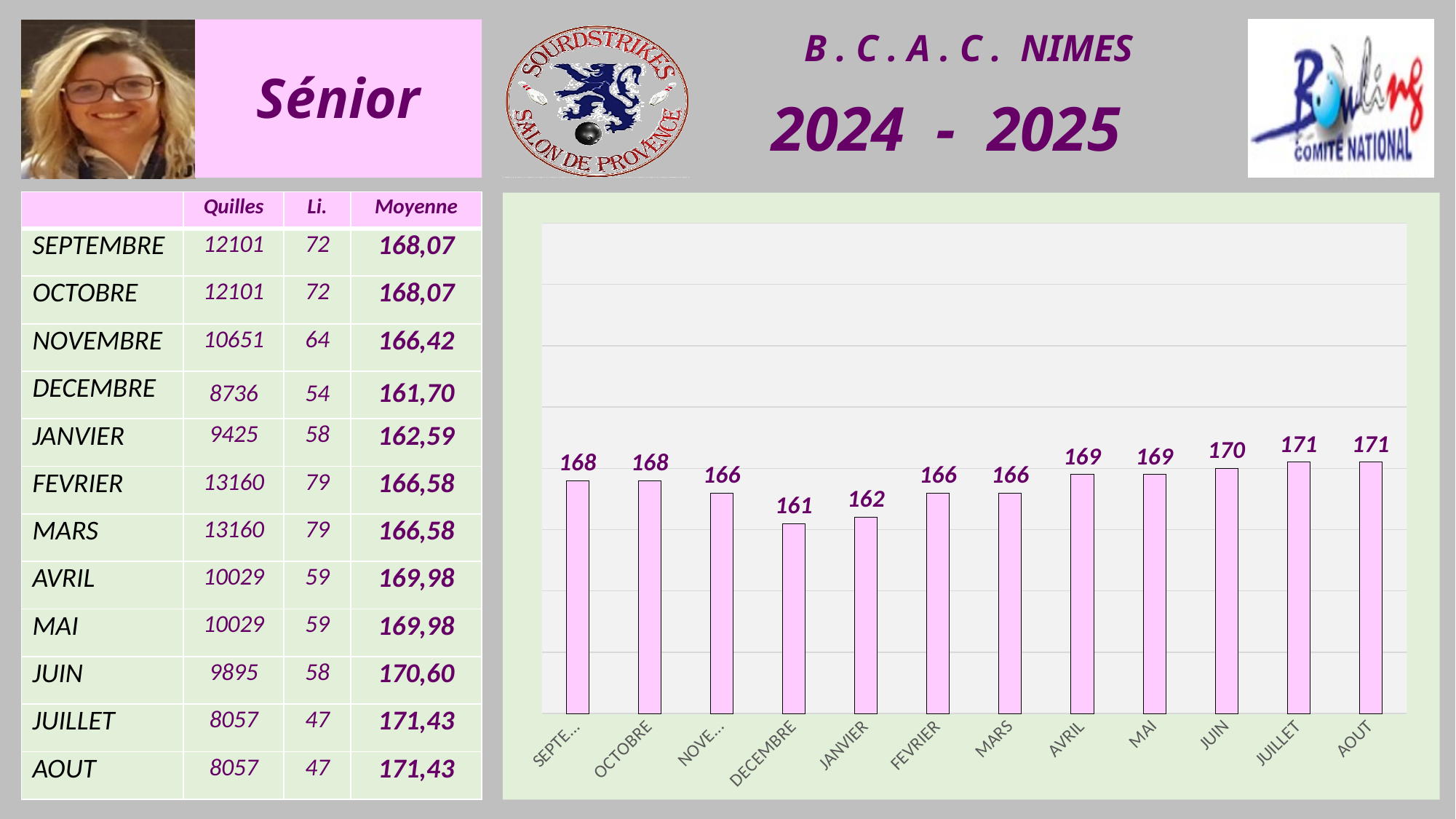
What is the value shown for JANVIER in the chart? 162 Which is larger in the chart, the value for AVRIL or the value for JANVIER? AVRIL What is the value shown for DECEMBRE in the chart? 161 Do the values in the chart rise or fall from DECEMBRE to AOUT? Rise What is the value shown for JUIN in the chart? 170 What kind of chart is shown on the slide? Bar chart What is the value shown for AOUT in the chart? 171 What is the value shown for AVRIL in the chart? 169 Which month has the lowest value in the chart? DECEMBRE What is the highest value labelled on the chart? 171 What is the difference between the values for JUILLET and DECEMBRE in the chart? 10 How many bars are plotted in the chart? 12